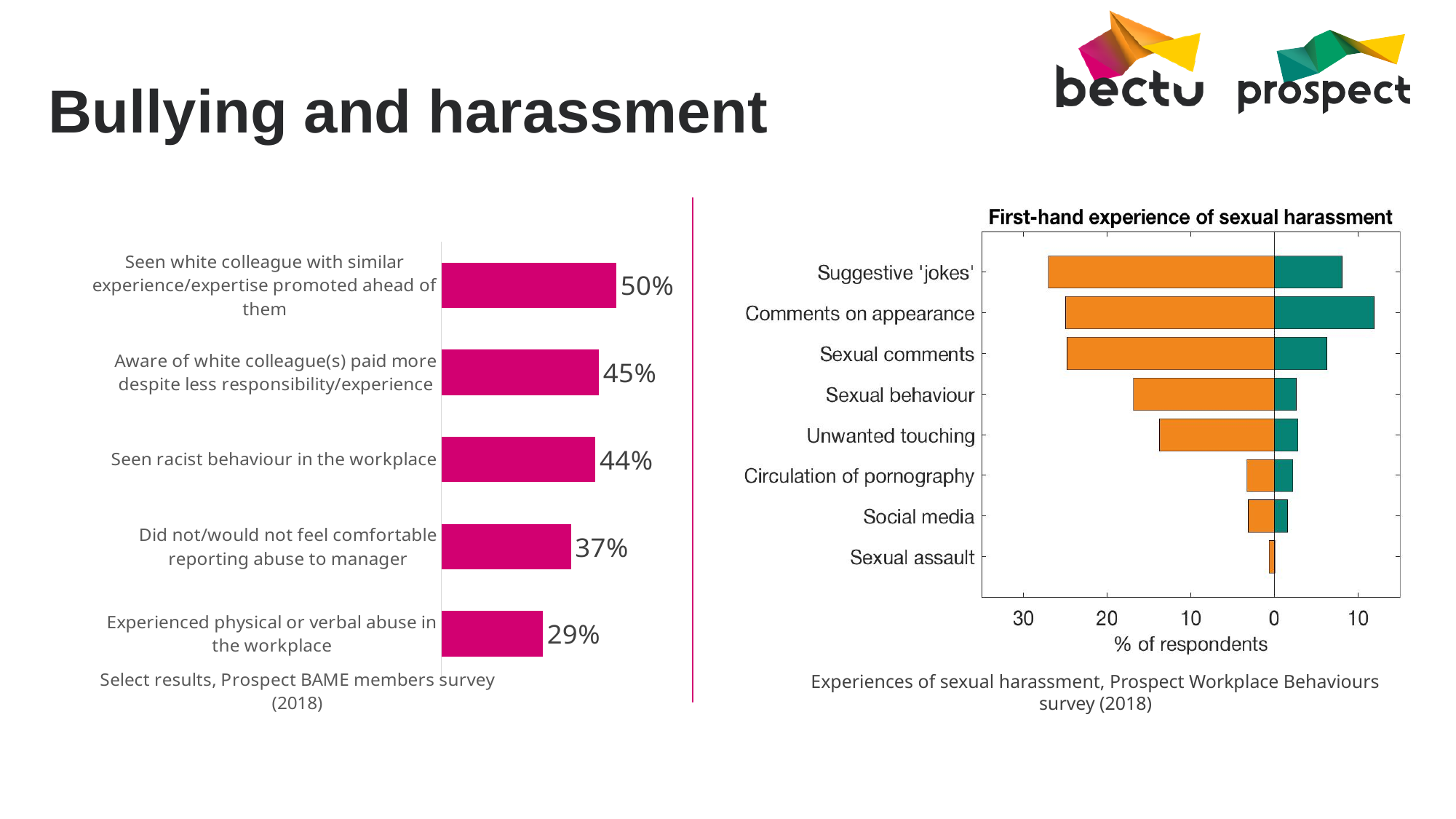
What type of chart is the left chart (Prospect BAME members survey)? Bar chart In the left chart (Prospect BAME members survey), what percentage did not/would not feel comfortable reporting abuse to a manager? 37% In the left chart (Prospect BAME members survey), what is the difference between the highest value and the lowest value? 21% In the 'First-hand experience of sexual harassment' chart, is the orange bar for Sexual assault greater or less than 10? less How many categories are shown in the left chart (Prospect BAME members survey)? 5 In the 'First-hand experience of sexual harassment' chart, which category has the longest green bar? Comments on appearance In the left chart (Prospect BAME members survey), which is larger: 'Aware of white colleague(s) paid more despite less responsibility/experience' or 'Did not/would not feel comfortable reporting abuse to manager'? Aware of white colleague(s) paid more despite less responsibility/experience In the left chart (Prospect BAME members survey), which category has the lowest value? Experienced physical or verbal abuse in the workplace In the 'First-hand experience of sexual harassment' chart, is the orange bar for Suggestive 'jokes' greater or less than 20? greater How many categories are shown in the 'First-hand experience of sexual harassment' chart? 8 In the left chart (Prospect BAME members survey), which category has the highest value? Seen white colleague with similar experience/expertise promoted ahead of them In the left chart (Prospect BAME members survey), what percentage had seen racist behaviour in the workplace? 44%